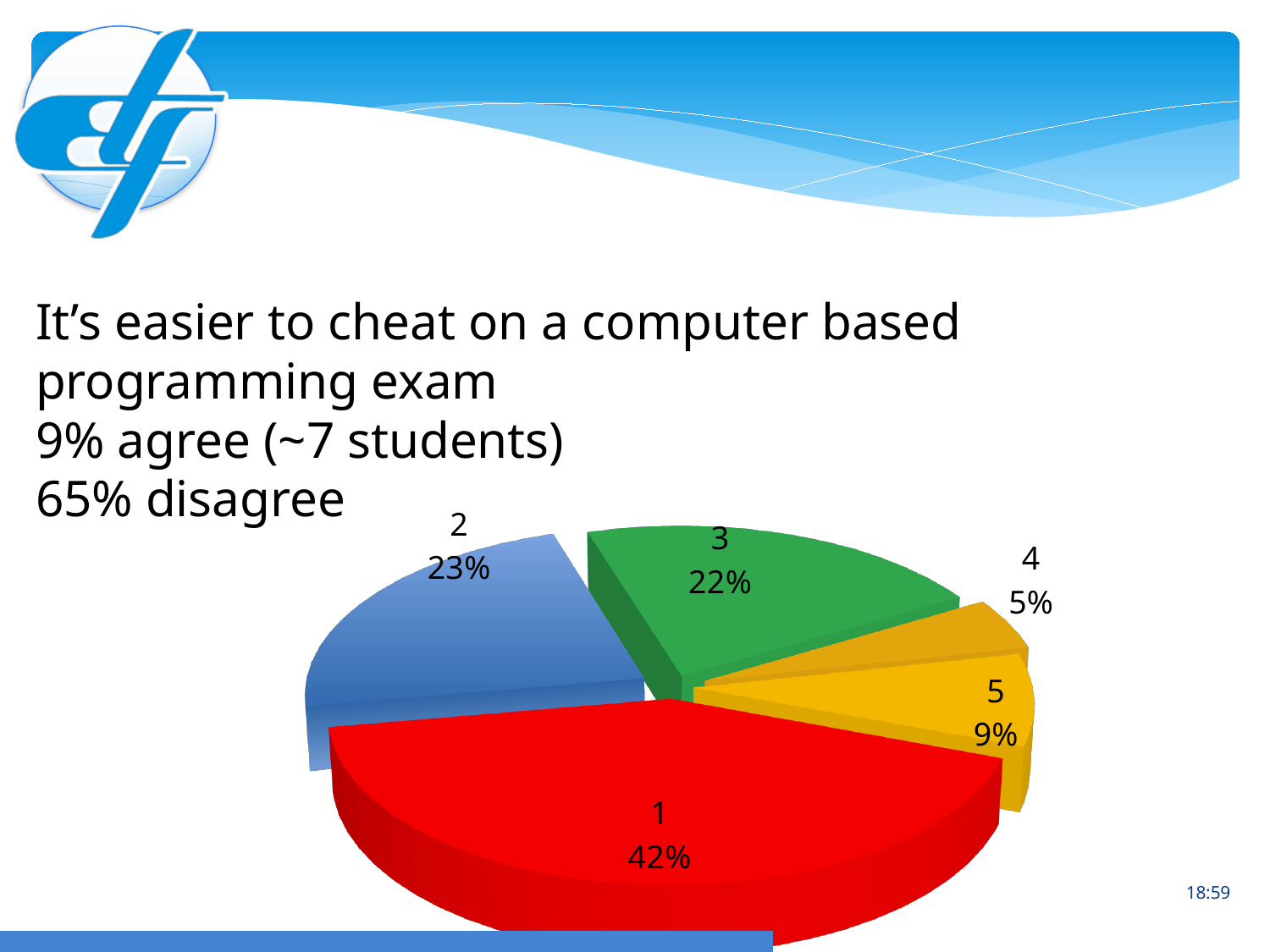
Which is larger, slice 5 or slice 4? 5 What kind of chart is shown on the slide? pie chart What percentage does slice 3 represent in the pie chart? 22% What is the difference in percentage points between slice 1 and slice 2? 19 What percentage does slice 5 represent in the pie chart? 9% What colour is slice 1 in the pie chart? red What percentage does slice 1 represent in the pie chart? 42% What percentage does slice 2 represent in the pie chart? 23% What percentage does slice 4 represent in the pie chart? 5% Which slice of the pie chart is the largest? 1 Which slice of the pie chart is the smallest? 4 How many slices does the pie chart have? 5